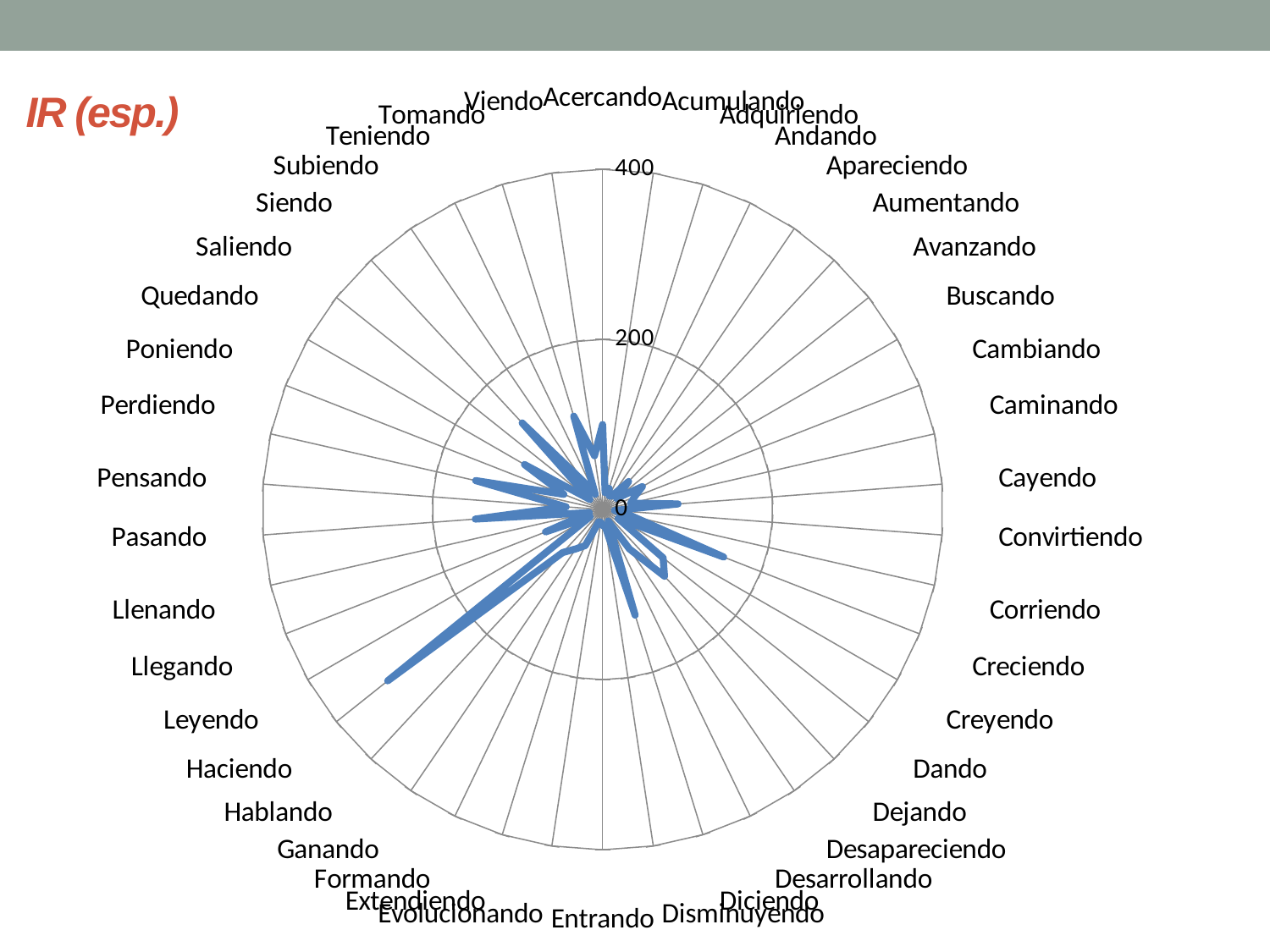
What is the maximum value shown on the radial axis? 400 Is the value for Haciendo greater or less than 400? less What kind of chart is shown on the slide? Radar chart Which category has the highest value in the radar chart? Haciendo What is the title shown on the slide for this chart? IR (esp.) Is the value for Caminando greater or less than 200? less Is the value for Cayendo greater or less than 200? less How many categories are plotted around the radar chart? 42 Which has the larger value, Haciendo or Buscando? Haciendo Which has the larger value, Haciendo or Caminando? Haciendo How many data series are plotted in the radar chart? 1